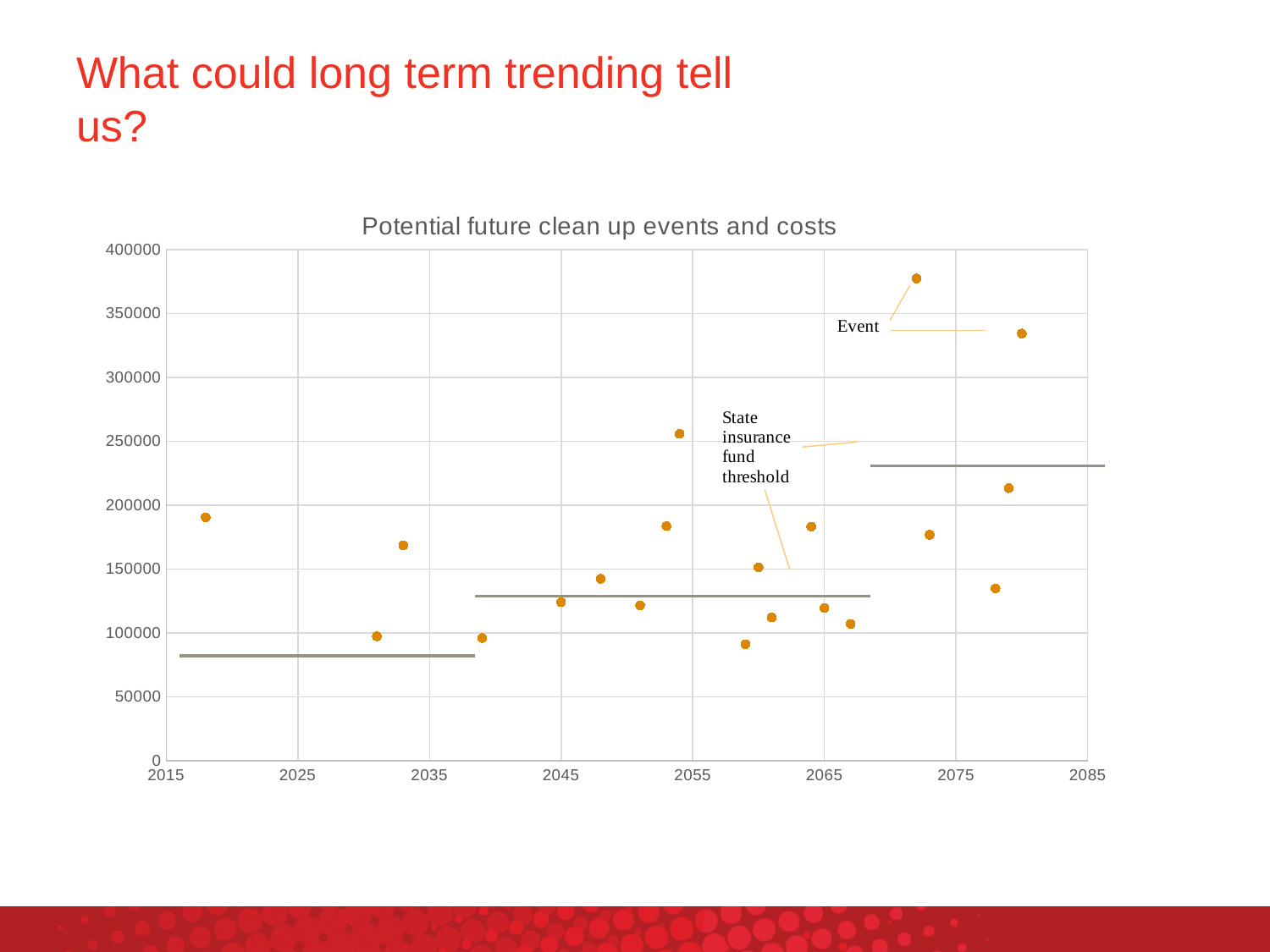
What kind of chart is shown on the slide? Scatter chart Is the value of the lowest point on the chart greater or less than 100000? less Which is larger: the value of the point near 2072 or the value of the point near 2080? The point near 2072 What is the title of the chart? Potential future clean up events and costs What label is attached to the horizontal lines on the chart? State insurance fund threshold Is the value of the point plotted near 2018 greater or less than 200000? less Is the value of the highest point on the chart greater or less than 350000? greater What is the highest value shown on the y axis? 400000 Do the State insurance fund threshold lines rise or fall from left to right across the chart? rise How many State insurance fund threshold line segments are drawn on the chart? 3 Is the highest-cost point located before or after 2065 on the x axis? after